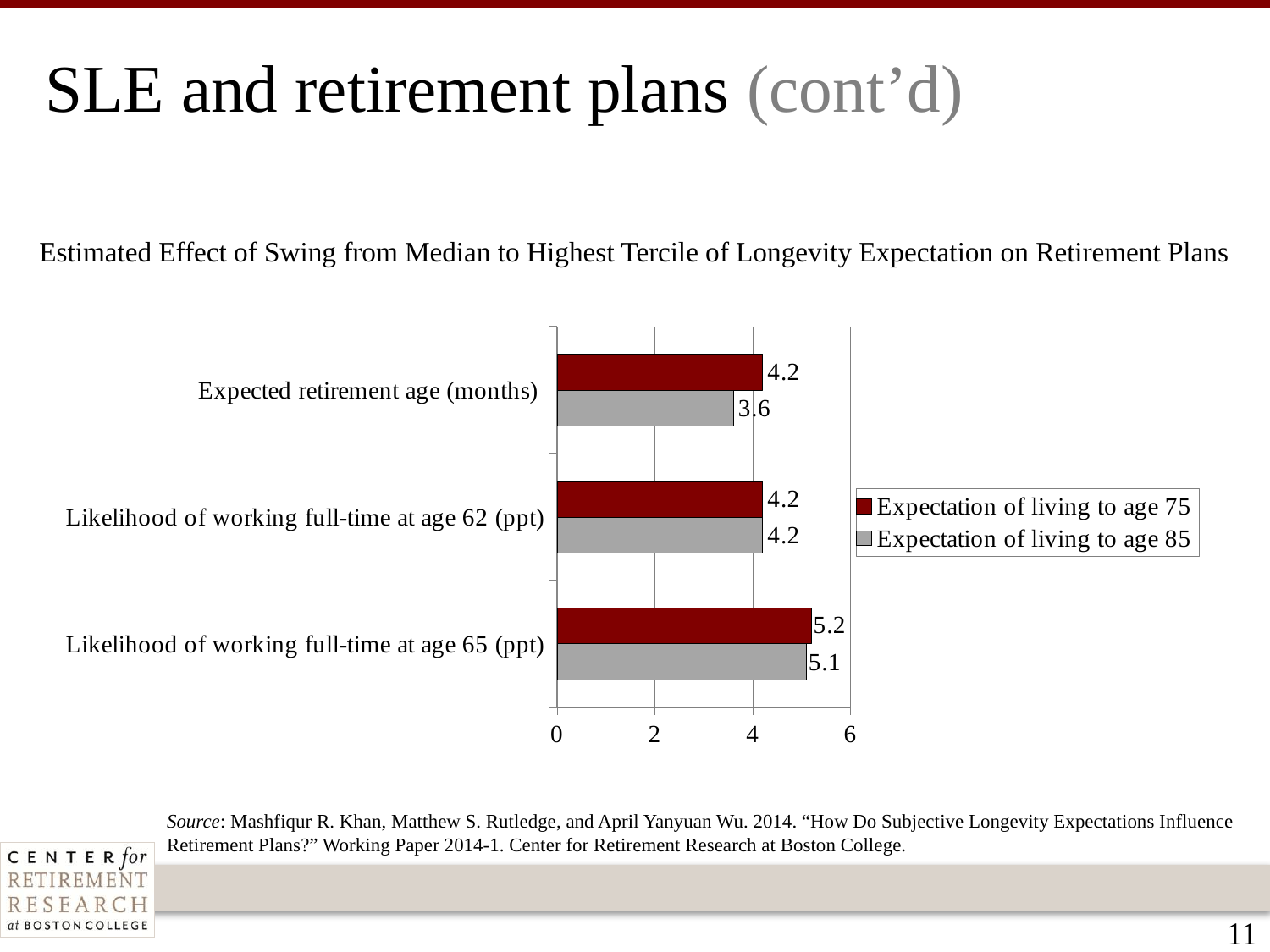
How many series does the legend list? 2 For Expected retirement age (months), which series has the larger value: 'Expectation of living to age 75' or 'Expectation of living to age 85'? Expectation of living to age 75 What is the value for 'Expectation of living to age 75' for Likelihood of working full-time at age 62 (ppt)? 4.2 What is the difference between the 'Expectation of living to age 75' and 'Expectation of living to age 85' values for Expected retirement age (months)? 0.6 What is the value for 'Expectation of living to age 75' for Expected retirement age (months)? 4.2 What is the value for 'Expectation of living to age 85' for Expected retirement age (months)? 3.6 How many categories are shown on the chart? 3 What is the value for 'Expectation of living to age 85' for Likelihood of working full-time at age 65 (ppt)? 5.1 What colour are the bars for 'Expectation of living to age 85'? Gray Which category has the lowest value for 'Expectation of living to age 85'? Expected retirement age (months) What kind of chart is shown on the slide? Bar chart Which category has the highest value for 'Expectation of living to age 75'? Likelihood of working full-time at age 65 (ppt)